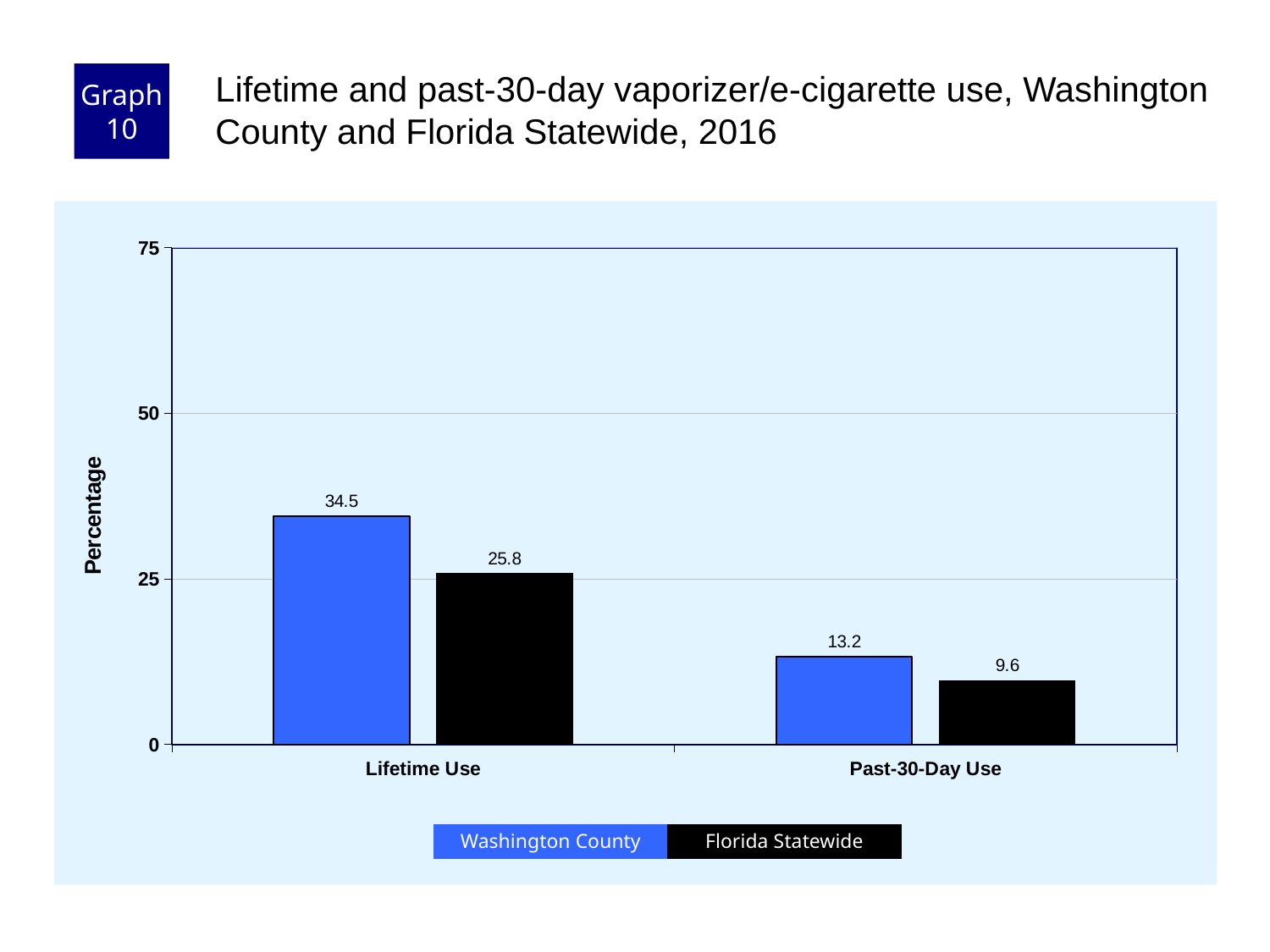
What kind of chart is shown on the slide? bar chart Which bar has the highest value on the chart? Washington County, Lifetime Use What is the Florida Statewide value for Past-30-Day Use? 9.6 What is the difference between the Washington County and Florida Statewide values for Past-30-Day Use? 3.6 What is the Washington County value for Lifetime Use? 34.5 Which bar has the lowest value on the chart? Florida Statewide, Past-30-Day Use How many categories are shown on the x axis? 2 Is the Washington County value for Lifetime Use greater or less than 25? greater For Past-30-Day Use, which is larger: Washington County or Florida Statewide? Washington County How many series does the legend list? 2 What is the difference between the Washington County and Florida Statewide values for Lifetime Use? 8.7 What is the Florida Statewide value for Lifetime Use? 25.8